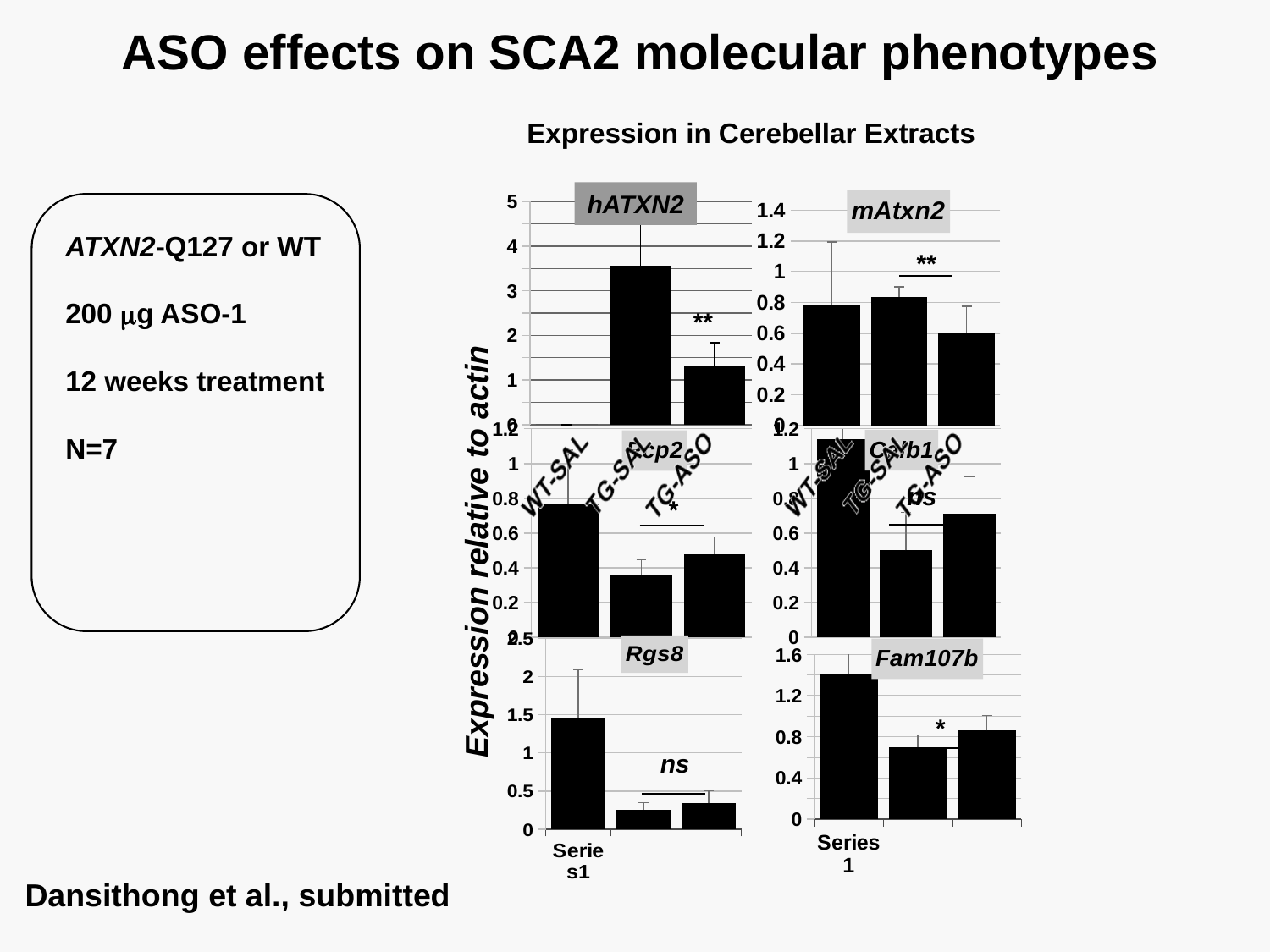
What is the shared y-axis label for the charts on the slide? Expression relative to actin In the hATXN2 chart, is the value for TG-SAL greater or less than 3? greater In the mAtxn2 chart, which category has the lowest bar? TG-ASO In the hATXN2 chart, is the value for TG-ASO greater or less than 2? less In the hATXN2 chart, which category has the highest bar? TG-SAL How many bars are plotted in the hATXN2 chart? 2 In the Fam107b chart, is the value of the second (middle) bar greater or less than 0.8? less In the hATXN2 chart, which is larger, the value for TG-SAL or the value for TG-ASO? TG-SAL What kind of chart is the hATXN2 chart? bar chart